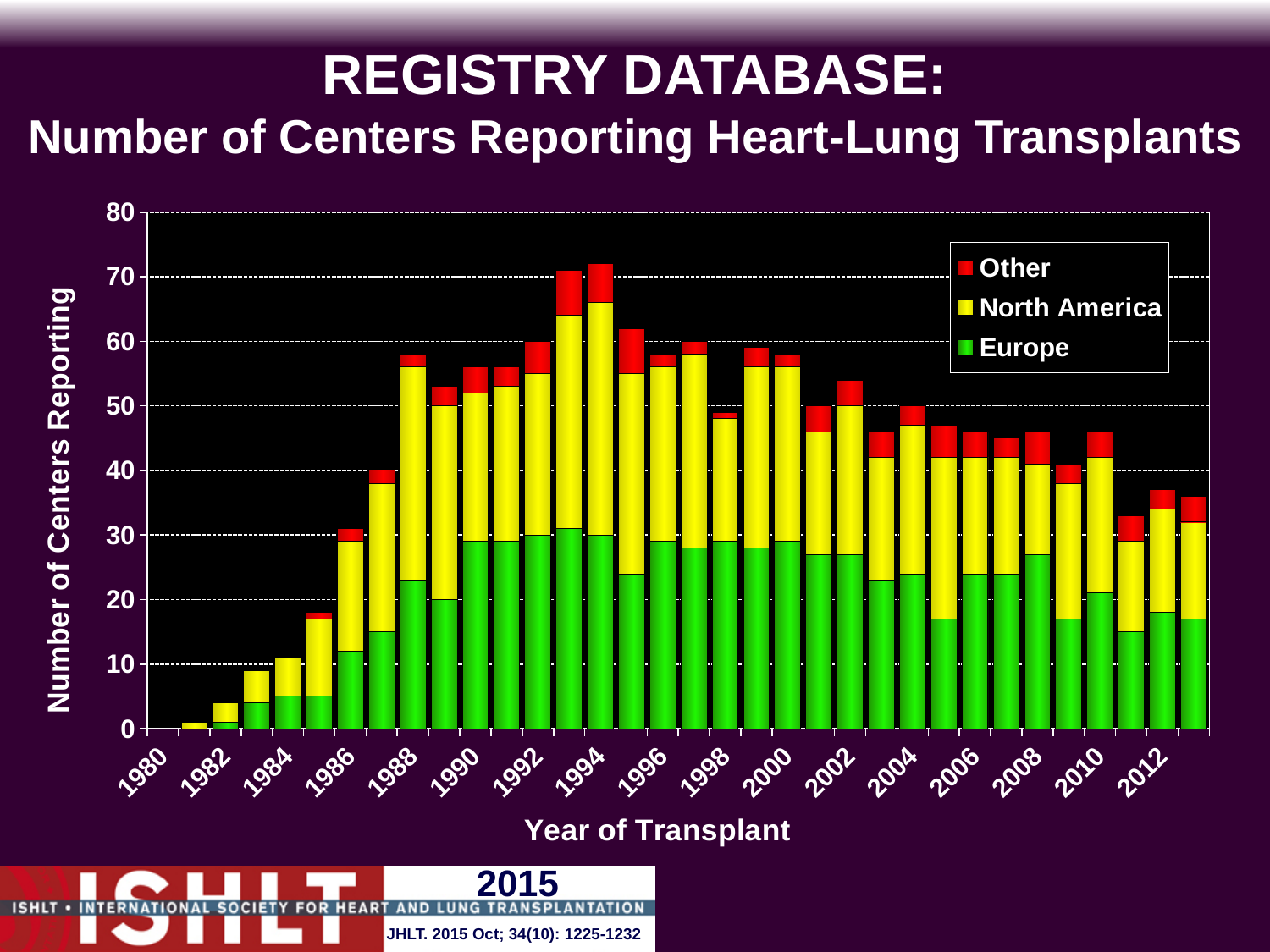
Is the number of Europe centers reporting in 2011 greater or less than 20? less Which year has the lowest total number of centers reporting? 1980 How many series does the legend list? 3 Is the number of Europe centers reporting in 2008 greater or less than 20? greater Which series is shown in green? Europe Does the total number of centers reporting generally rise or fall from 1994 to 2013? fall What kind of chart is shown on the slide? Stacked bar chart Is the total number of centers reporting in 2011 greater or less than 40? less Which year has a larger total number of centers reporting, 1988 or 2008? 1988 What is the title of the vertical axis? Number of Centers Reporting